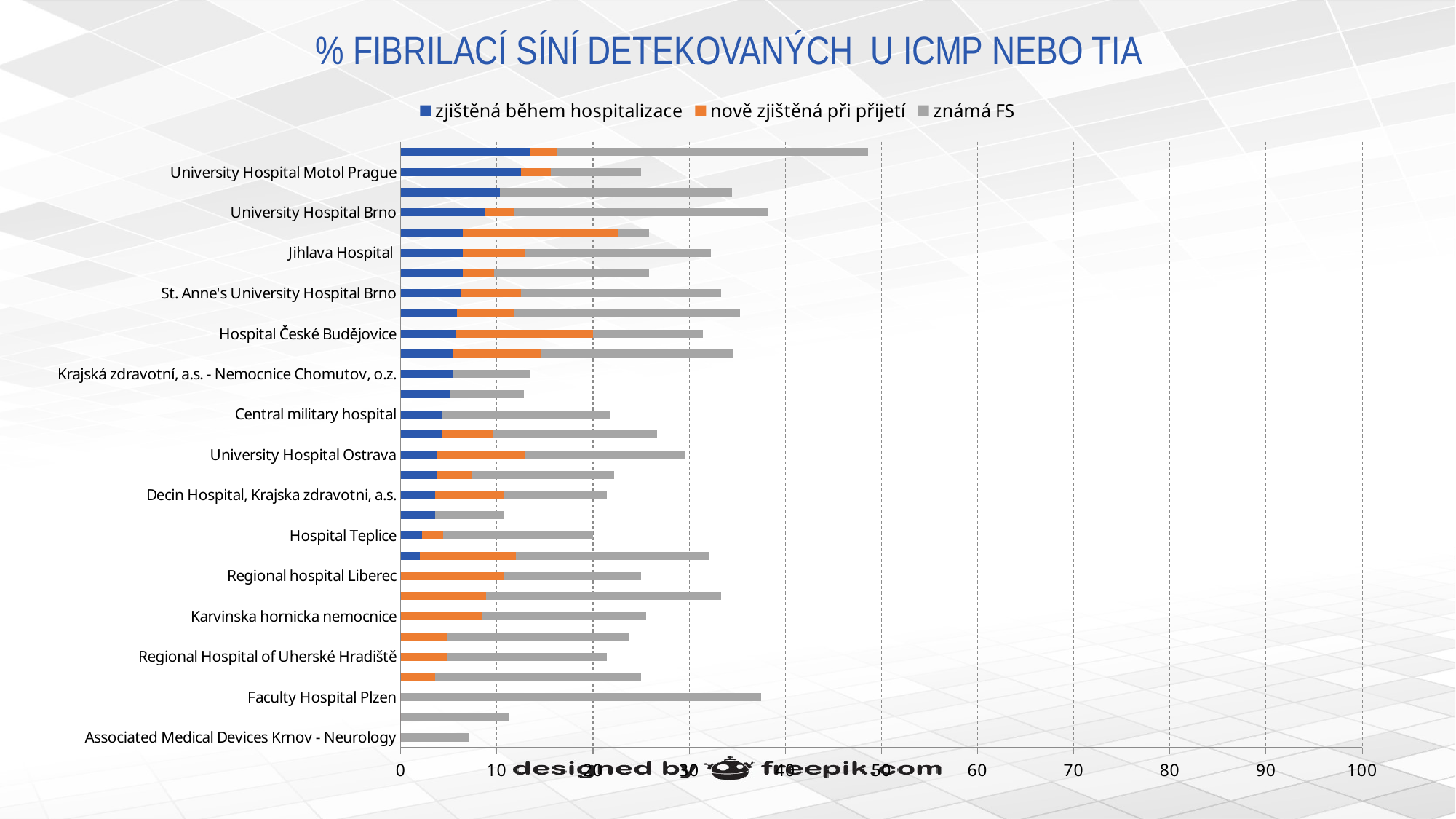
What is the title of the chart? % FIBRILACÍ SÍNÍ DETEKOVANÝCH U ICMP NEBO TIA Is the total bar length for Hospital Teplice greater or less than 30? less Which has the longer total bar: Faculty Hospital Plzen or Associated Medical Devices Krnov - Neurology? Faculty Hospital Plzen How many series does the legend list? 3 Among the labelled hospitals, which has the shortest total bar? Associated Medical Devices Krnov - Neurology Is the total bar length for University Hospital Brno greater or less than 30? greater Is the total bar length for Faculty Hospital Plzen greater or less than 30? greater Which colour represents the series "známá FS" in the chart? Grey What type of chart is shown on the slide? Bar chart Which has the longer total bar: University Hospital Brno or Krajská zdravotní, a.s. - Nemocnice Chomutov, o.z.? University Hospital Brno